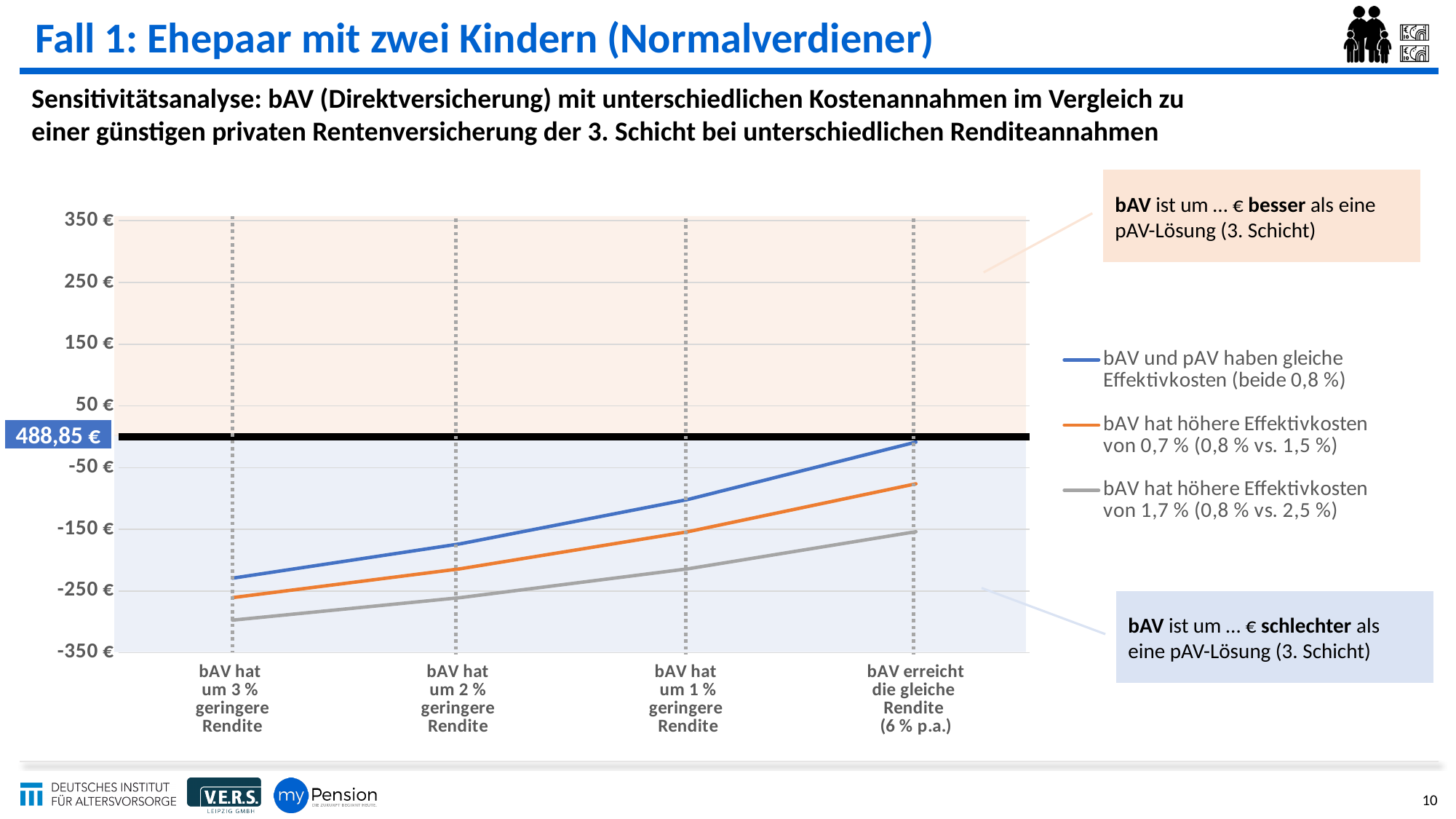
Is the value of the series 'bAV hat höhere Effektivkosten von 0,7 % (0,8 % vs. 1,5 %)' at 'bAV erreicht die gleiche Rendite (6 % p.a.)' greater or less than -150 €? greater Which series has the highest value at 'bAV erreicht die gleiche Rendite (6 % p.a.)'? bAV und pAV haben gleiche Effektivkosten (beide 0,8 %) Is the value of the series 'bAV hat höhere Effektivkosten von 1,7 % (0,8 % vs. 2,5 %)' at 'bAV hat um 3 % geringere Rendite' greater or less than -250 €? less How many series does the legend list? 3 Which series has the lowest value at 'bAV hat um 3 % geringere Rendite'? bAV hat höhere Effektivkosten von 1,7 % (0,8 % vs. 2,5 %) What value is labelled on the thick black horizontal reference line in the chart? 488,85 € How many categories are shown along the x axis? 4 Do the values of the series 'bAV hat höhere Effektivkosten von 1,7 % (0,8 % vs. 2,5 %)' rise or fall from left to right along the x axis? rise Is the value of the series 'bAV und pAV haben gleiche Effektivkosten (beide 0,8 %)' at 'bAV hat um 3 % geringere Rendite' greater or less than -150 €? less What kind of chart is shown on the slide? line chart At 'bAV hat um 2 % geringere Rendite', which is larger: the value of the series 'bAV hat höhere Effektivkosten von 0,7 % (0,8 % vs. 1,5 %)' or the series 'bAV hat höhere Effektivkosten von 1,7 % (0,8 % vs. 2,5 %)'? bAV hat höhere Effektivkosten von 0,7 % (0,8 % vs. 1,5 %) Do the values of the series 'bAV und pAV haben gleiche Effektivkosten (beide 0,8 %)' rise or fall from left to right along the x axis? rise